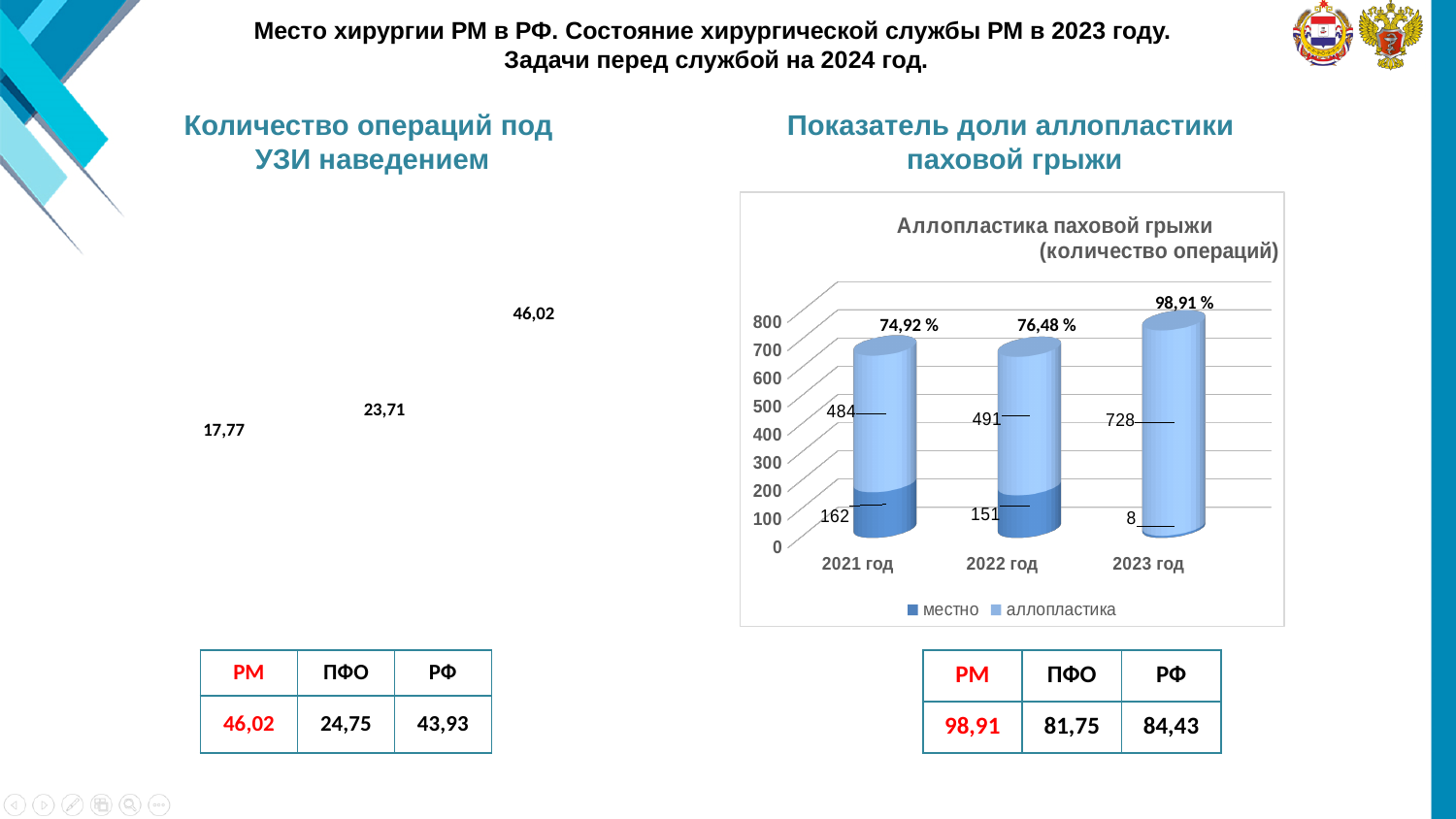
In the chart 'Аллопластика паховой грыжи', which year has the highest 'аллопластика' value? 2023 год How many years are shown on the x axis of the chart 'Аллопластика паховой грыжи'? 3 In the chart 'Аллопластика паховой грыжи', what is the total of the stacked bar for 2021 год? 646 How many series does the legend of the chart 'Аллопластика паховой грыжи' list? 2 What kind of chart is 'Аллопластика паховой грыжи'? Stacked bar chart In the chart 'Аллопластика паховой грыжи', what percentage label is shown above the bar for 2023 год? 98,91 % In the chart 'Аллопластика паховой грыжи', which year has the lowest 'местно' value? 2023 год In the chart 'Аллопластика паховой грыжи', what is the value of 'местно' for 2023 год? 8 In the chart 'Аллопластика паховой грыжи', what is the value of 'местно' for 2021 год? 162 In the chart 'Аллопластика паховой грыжи', what is the value of 'аллопластика' for 2023 год? 728 In the chart 'Аллопластика паховой грыжи', what is the difference between the 'аллопластика' values for 2023 год and 2021 год? 244 In the chart 'Аллопластика паховой грыжи', which is larger: the 'аллопластика' value for 2021 год or for 2022 год? 2022 год